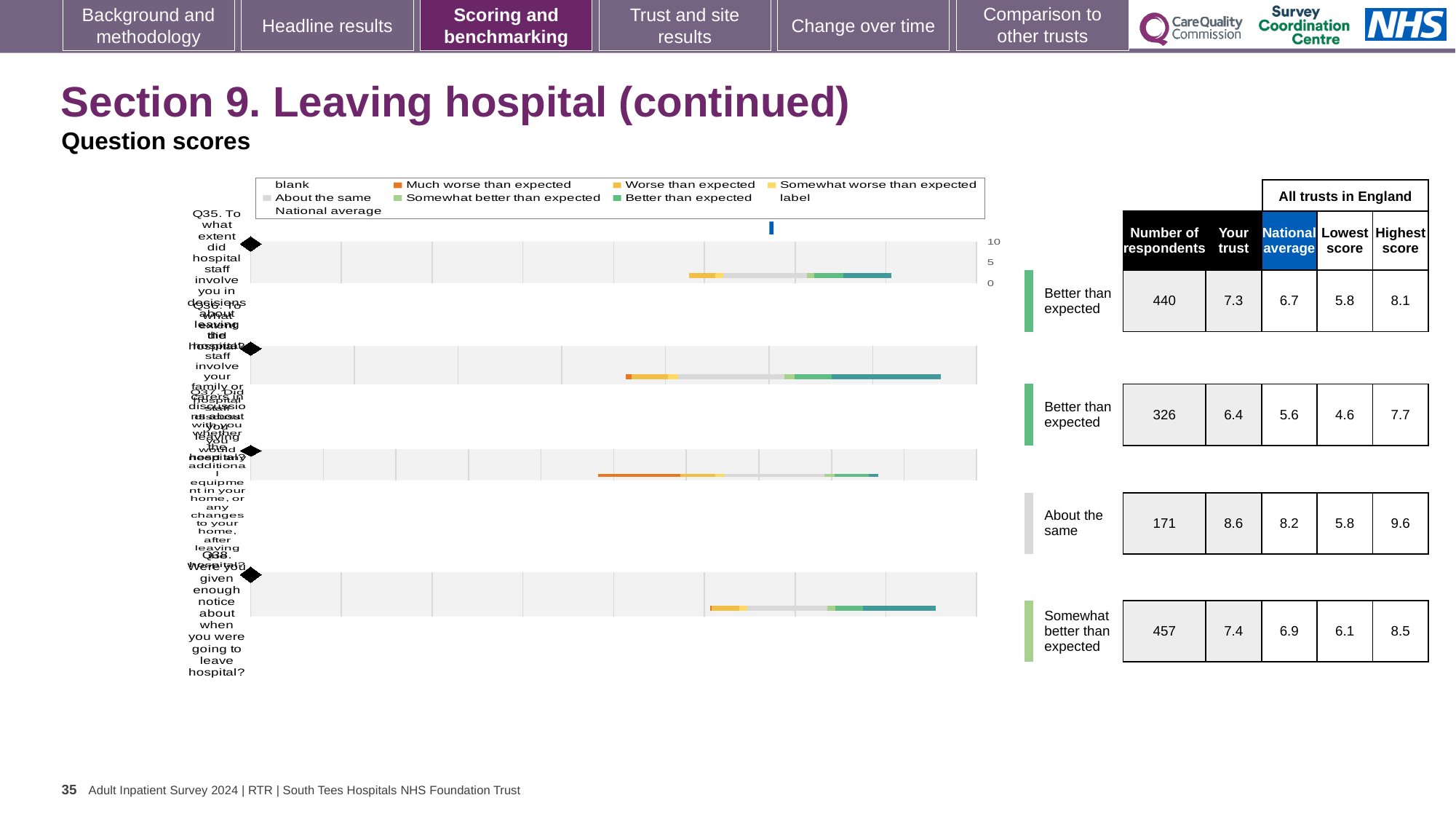
For Q35, what is the difference between the 'Your trust' score and the national average? 0.6 What kind of chart is used to show the question scores on this slide? bar chart How many question rows are plotted in the chart? 4 What is the highest 'Your trust' score shown in the table? 8.6 What is the highest score in England listed for Q38? 8.5 For Q35, which is larger: the 'Your trust' score or the national average? Your trust Which benchmark category is Q38 rated as? Somewhat better than expected What is the 'Your trust' score for Q38 (were you given enough notice about when you were going to leave hospital)? 7.4 Which benchmark category is Q35 rated as? Better than expected What is the 'Your trust' score for Q35 (to what extent did hospital staff involve you in decisions about leaving hospital)? 7.3 What is the national average score for Q38? 6.9 How many respondents are listed for Q35? 440